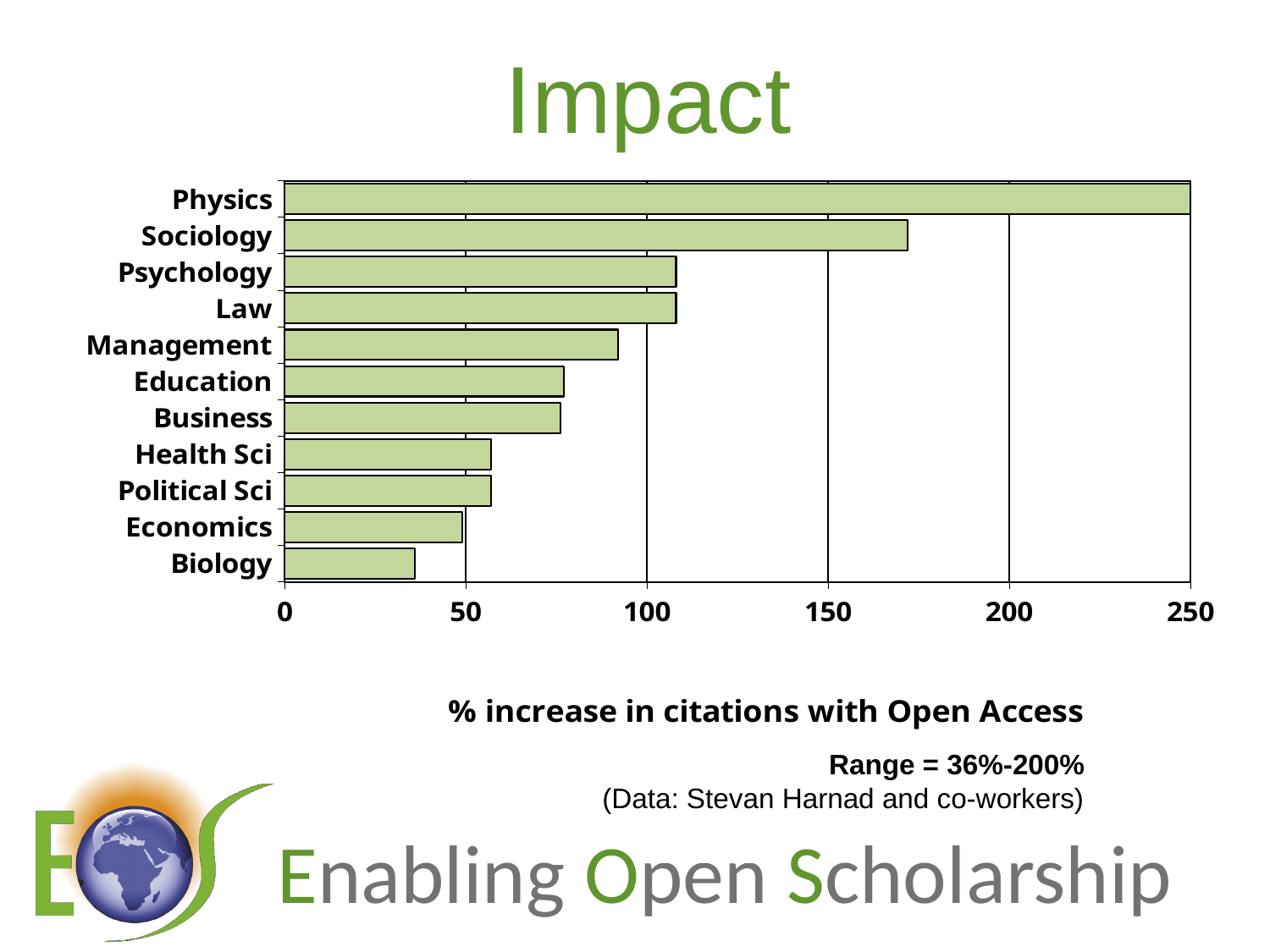
Is the value for Sociology greater or less than 150? greater How many disciplines are plotted in the chart? 11 What kind of chart is shown on the slide? bar chart Which has the larger value, Sociology or Management? Sociology Is the value for Management greater or less than 100? less Which discipline has the highest % increase in citations with Open Access? Physics What does the chart measure, according to the caption below it? % increase in citations with Open Access Is the value for Physics greater or less than 200? greater Which discipline has the lowest % increase in citations with Open Access? Biology Which has the larger value, Education or Health Sci? Education